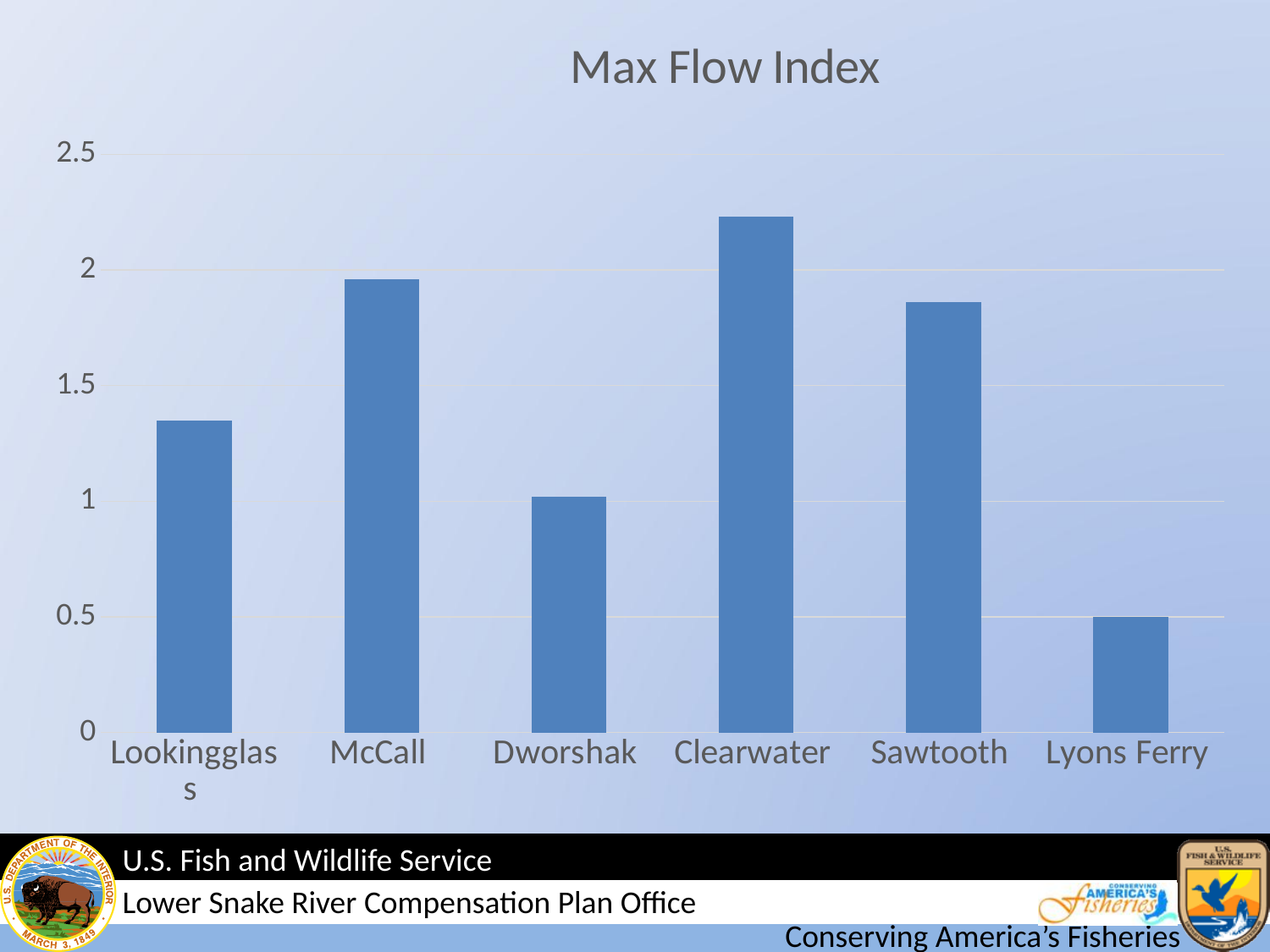
Which category has the highest Max Flow Index? Clearwater Is the value for Lyons Ferry greater or less than 1? less Which has a lower Max Flow Index, Sawtooth or Lyons Ferry? Lyons Ferry Is the value for Lookingglass greater or less than 1.5? less Is the value for Sawtooth greater or less than 1.5? greater Which has a higher Max Flow Index, Clearwater or McCall? Clearwater Which category has the lowest Max Flow Index? Lyons Ferry Which has a higher Max Flow Index, Lookingglass or Dworshak? Lookingglass What is the title of the chart? Max Flow Index How many categories are shown on the x axis of the chart? 6 What kind of chart is shown on the slide? bar chart